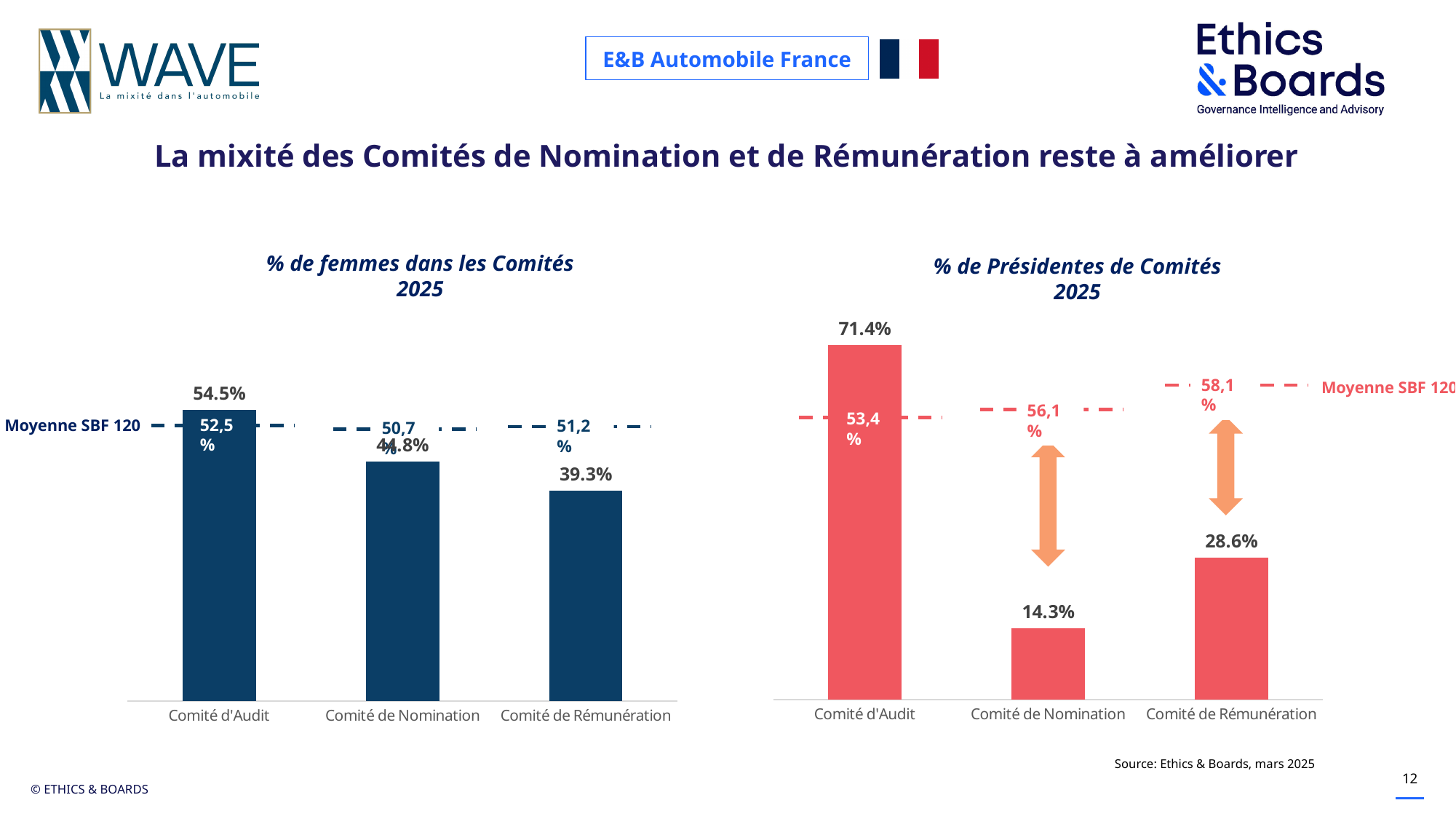
In the chart '% de Présidentes de Comités 2025', what is the value for Comité de Rémunération? 28.6% In the chart '% de Présidentes de Comités 2025', what is the value for Comité d'Audit? 71.4% In the chart '% de Présidentes de Comités 2025', what is the difference between Comité de Rémunération and Comité de Nomination? 14.3 percentage points In the chart '% de Présidentes de Comités 2025', what is the Moyenne SBF 120 value shown for Comité de Rémunération? 58,1 % How many committees are shown in the chart '% de Présidentes de Comités 2025'? 3 In the chart '% de Présidentes de Comités 2025', what is the value for Comité de Nomination? 14.3% In the chart '% de femmes dans les Comités 2025', what is the Moyenne SBF 120 value shown for Comité d'Audit? 52,5 % In the chart '% de Présidentes de Comités 2025', which committee has the highest value? Comité d'Audit In the chart '% de femmes dans les Comités 2025', what is the difference between Comité d'Audit and Comité de Rémunération? 15.2 percentage points In the chart '% de femmes dans les Comités 2025', what is the value for Comité d'Audit? 54.5% In the chart '% de femmes dans les Comités 2025', what is the value for Comité de Rémunération? 39.3% In the chart '% de femmes dans les Comités 2025', which committee has the lowest percentage of women? Comité de Rémunération